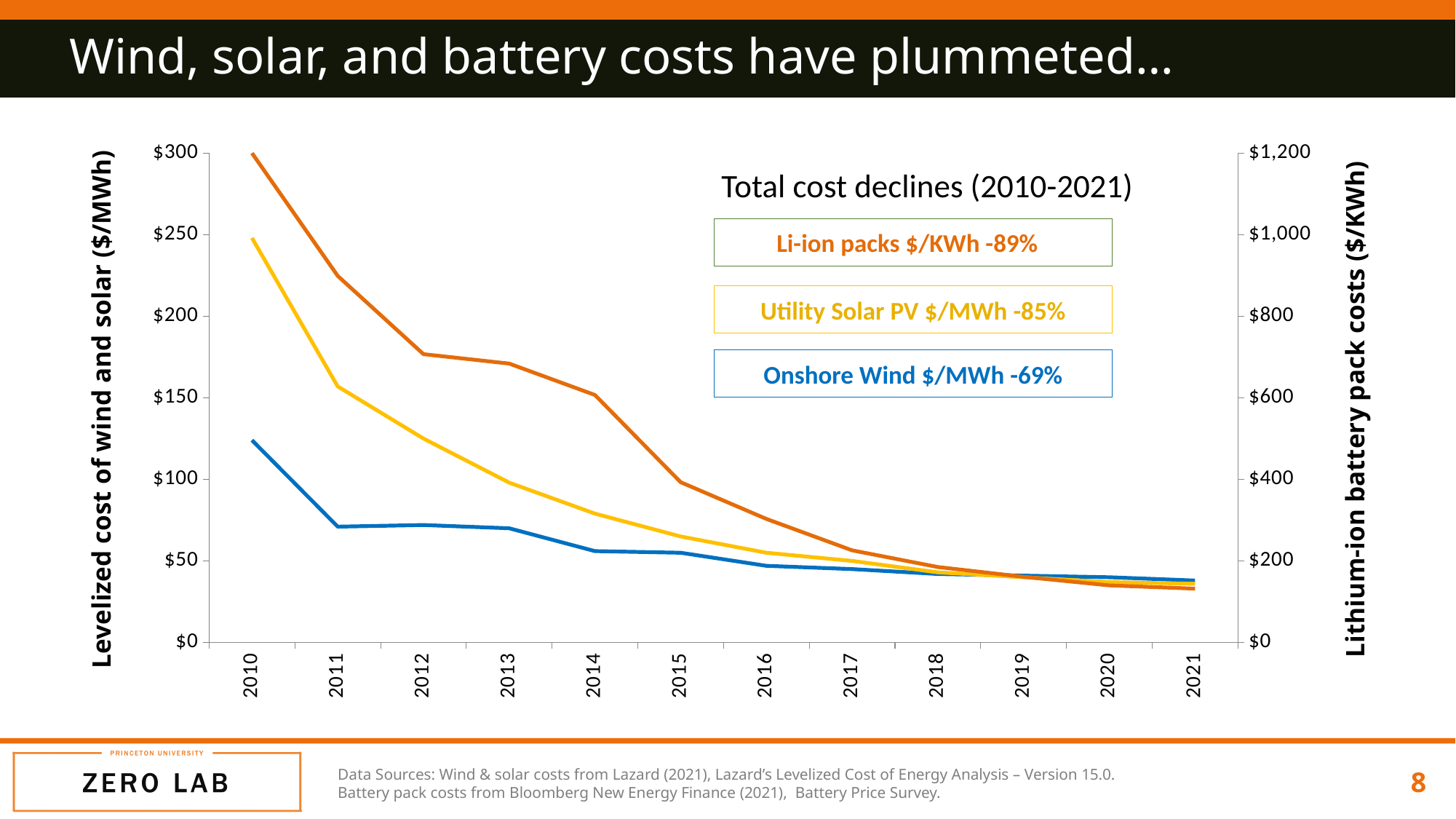
How many years are shown along the x axis of the chart? 12 Which technology shows the smallest total cost decline from 2010 to 2021? Onshore Wind What kind of chart is shown on the slide? Line chart What is the total cost decline (2010-2021) shown for Li-ion packs? -89% Which technology shows the largest total cost decline from 2010 to 2021? Li-ion packs Is the Li-ion pack cost in 2010 greater or less than $1,000/KWh? greater Do the plotted costs rise or fall from 2010 to 2021? Fall What is the total cost decline (2010-2021) shown for Onshore Wind? -69% In 2010, which is higher on the left axis: Utility Solar PV or Onshore Wind? Utility Solar PV Is the Onshore Wind value in 2010 greater or less than $100/MWh? greater What is the total cost decline (2010-2021) shown for Utility Solar PV? -85% How many series are plotted on the chart? 3